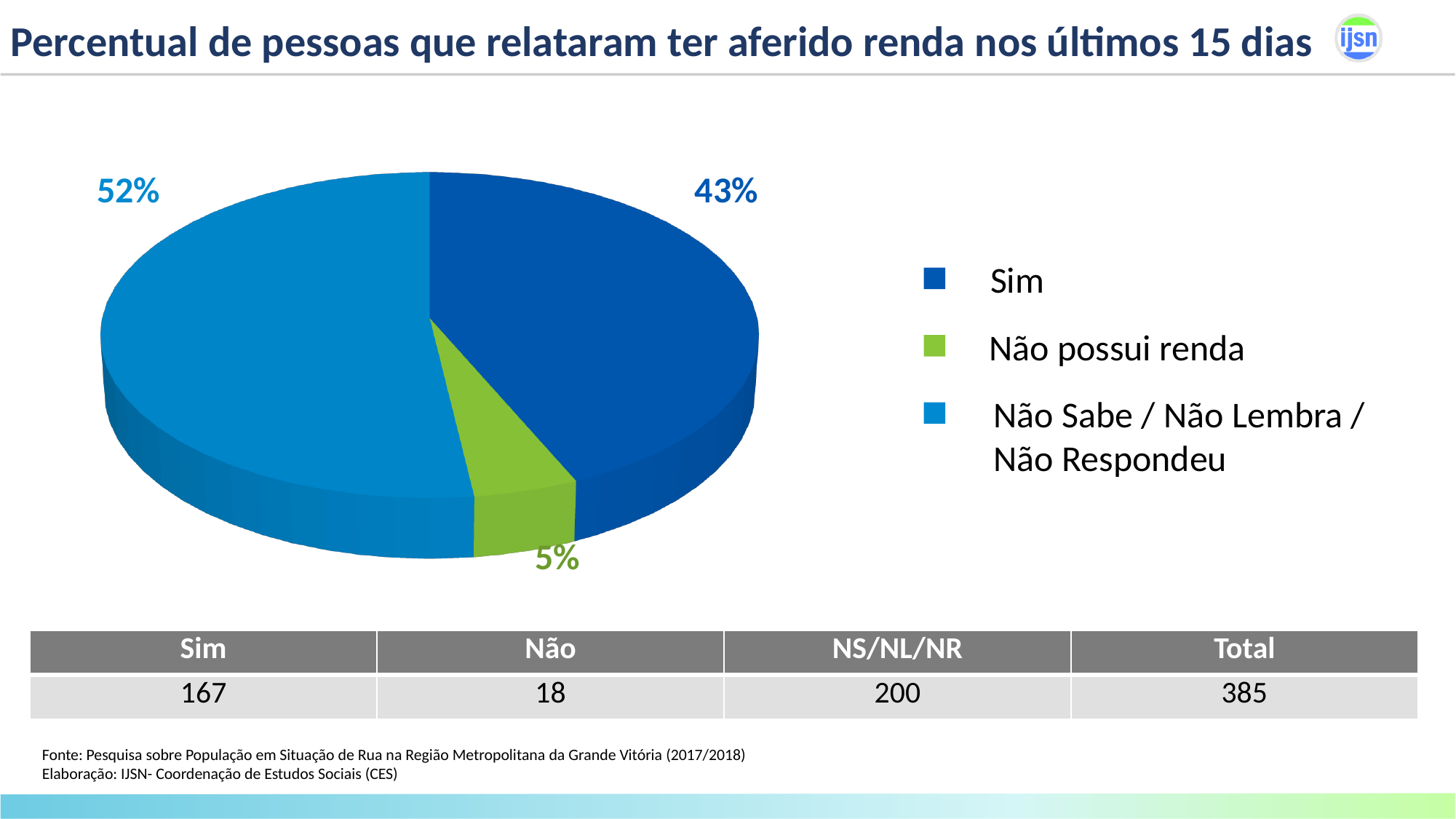
What percentage of the pie chart is the 'Não possui renda' slice? 5% How many entries does the legend list? 3 Which slice is larger, 'Sim' or 'Não possui renda'? Sim What percentage of the pie chart is the 'Sim' slice? 43% What percentage of the pie chart is the 'Não Sabe / Não Lembra / Não Respondeu' slice? 52% What colour is the 'Não possui renda' slice in the pie chart? Green How many slices does the pie chart have? 3 What is the difference in percentage points between the 'Não Sabe / Não Lembra / Não Respondeu' slice and the 'Sim' slice? 9 percentage points Which category has the smallest share of the pie chart? Não possui renda What kind of chart is shown on the slide? Pie chart Which category has the largest share of the pie chart? Não Sabe / Não Lembra / Não Respondeu What is the title of the chart on the slide? Percentual de pessoas que relataram ter aferido renda nos últimos 15 dias